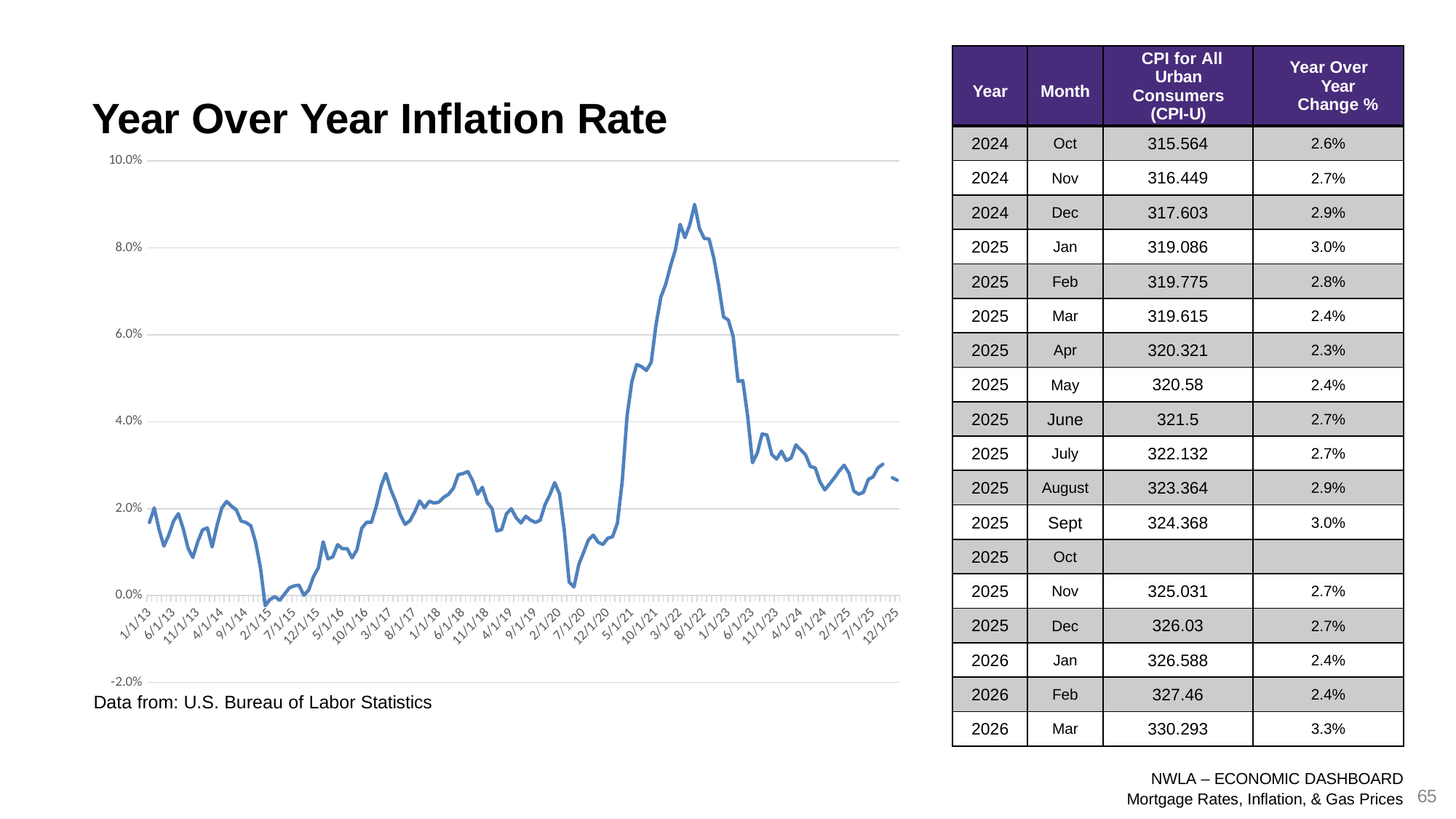
Does the line rise or fall between 8/1/22 and 6/1/23? fall In which year does the line reach its highest point? 2022 Does the line rise or fall between 2/1/20 and 8/1/22? rise What is the title of the chart? Year Over Year Inflation Rate Is the value at 7/1/20 greater or less than 2.0%? less Is the value at 1/1/13 greater or less than 4.0%? less What kind of chart is shown on the slide? line chart Is the peak value of the line greater or less than 8.0%? greater In which year does the line reach its lowest point? 2015 What is the highest value shown on the chart's vertical axis? 10.0%